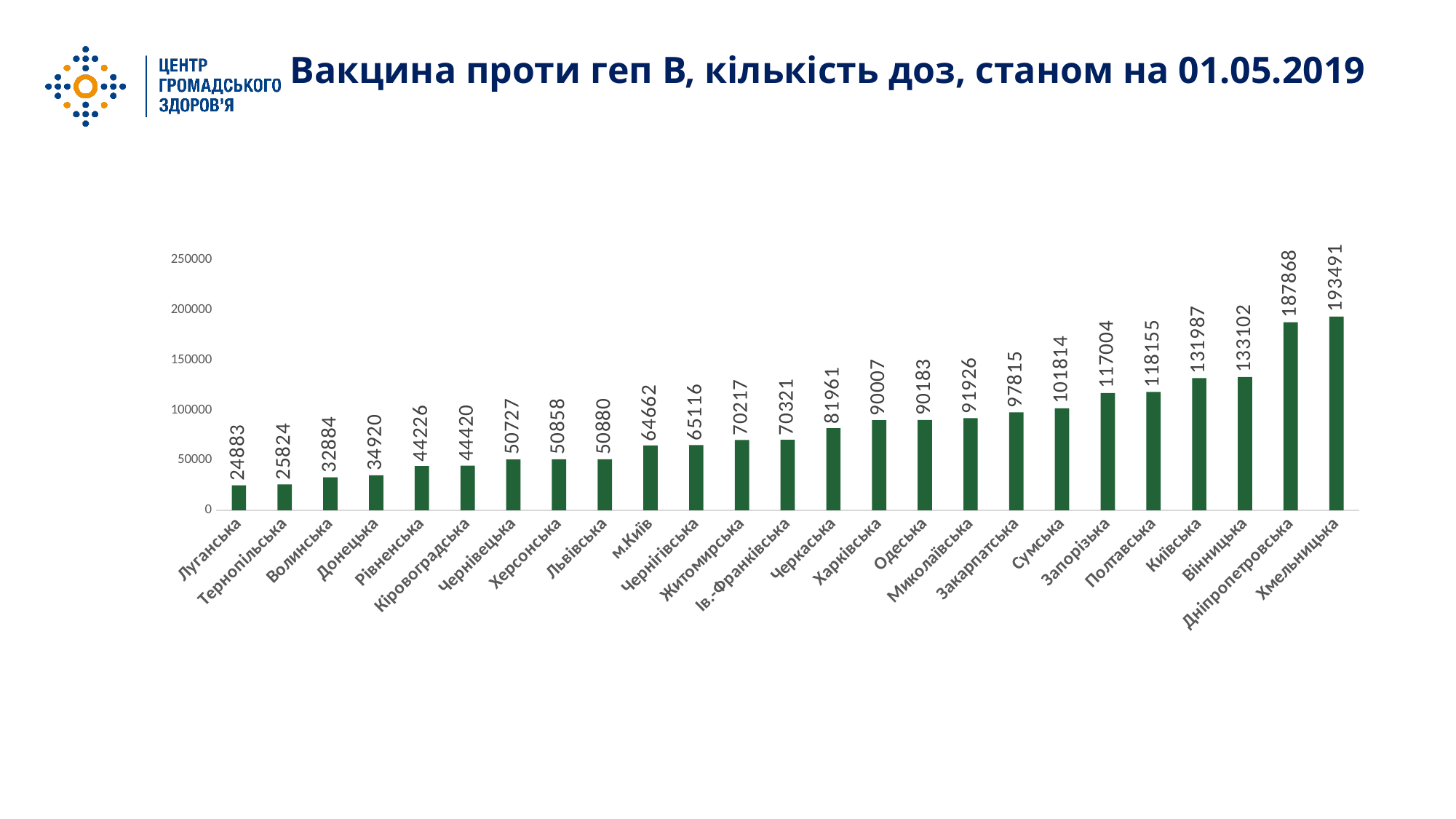
How many regions are shown on the chart? 25 What is the number of doses for м.Київ? 64662 Which region has the highest number of doses? Хмельницька What type of chart is shown on the slide? bar chart Which has more doses, Вінницька or Полтавська? Вінницька Do the values rise or fall from left to right along the x axis? rise What is the difference in doses between Сумська and Закарпатська? 3999 Which region has the lowest number of doses? Луганська Is the value for Черкаська greater or less than 100000? less What is the number of doses for Дніпропетровська? 187868 What is the number of doses for Харківська? 90007 What is the difference in doses between Хмельницька and Дніпропетровська? 5623